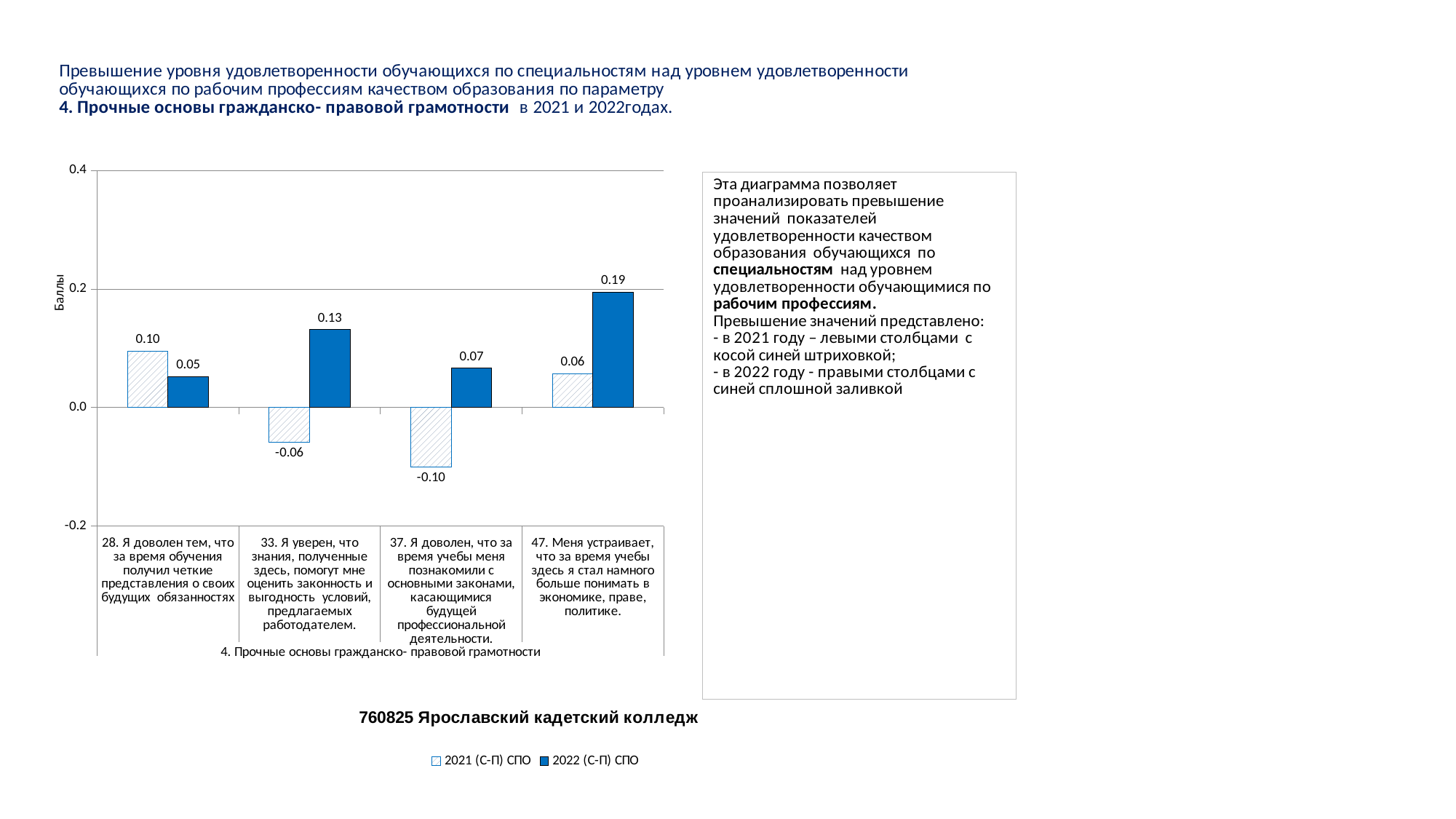
What is the value of the 2022 (С-П) СПО series for category 47? 0.19 Which category has the lowest value in the 2021 (С-П) СПО series? 37 What is the value of the 2021 (С-П) СПО series for category 28? 0.10 Which category has the highest value in the 2022 (С-П) СПО series? 47 What is the difference between the 2022 and 2021 values for category 47? 0.13 What is the value of the 2022 (С-П) СПО series for category 33? 0.13 How many series does the legend list? 2 How many categories (questions) are shown on the x axis? 4 What is the label of the vertical axis? Баллы What is the value of the 2021 (С-П) СПО series for category 37? -0.10 For category 28, which series has the larger value, 2021 (С-П) СПО or 2022 (С-П) СПО? 2021 (С-П) СПО What type of chart is shown on the slide? bar chart